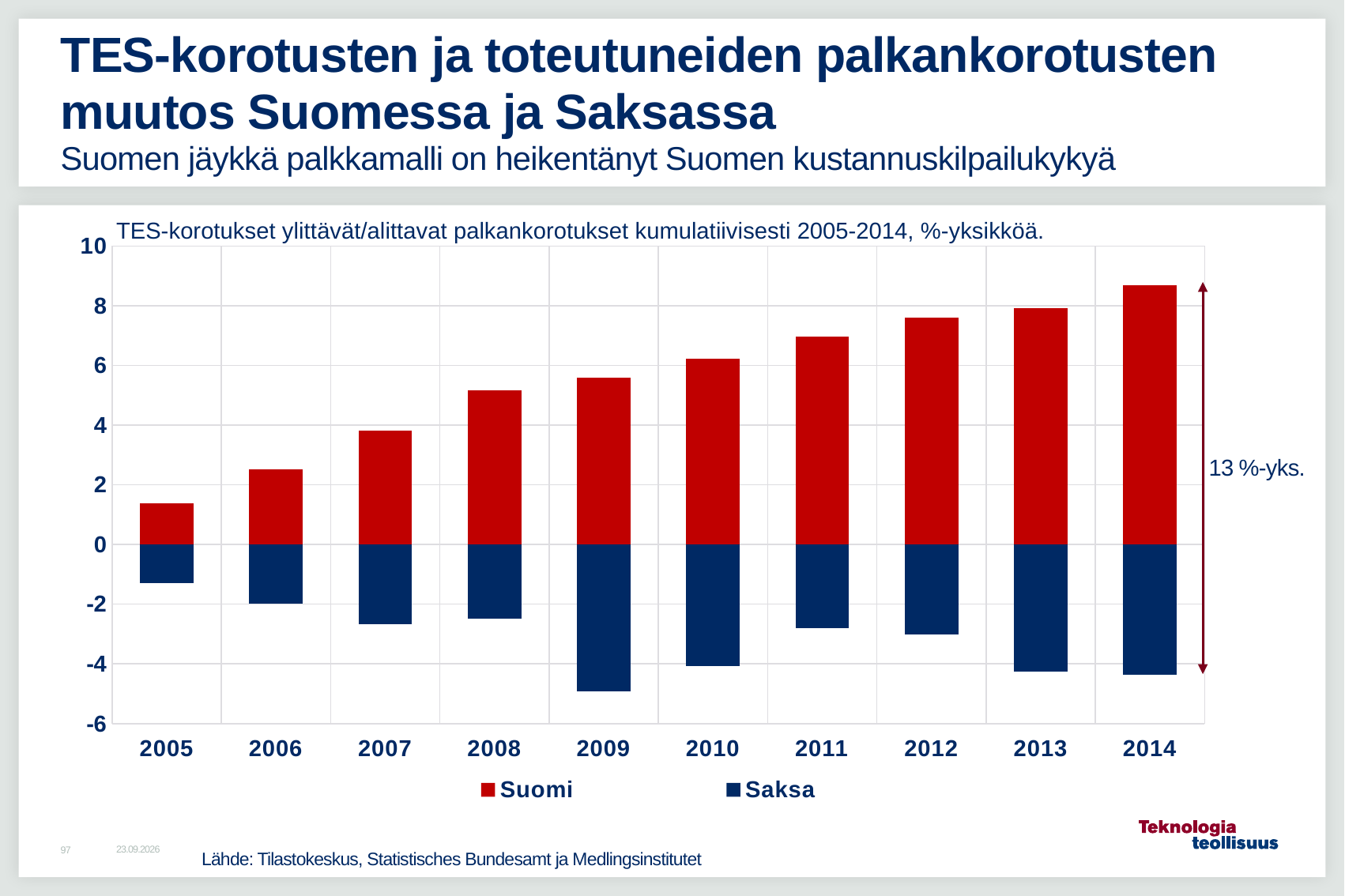
In which year does the Saksa bar reach its most negative value? 2009 How many years are shown on the x axis of the chart? 10 In which year is the Suomi bar the lowest? 2005 Which year has the larger Suomi value, 2007 or 2008? 2008 How many series does the chart legend list? 2 In which year is the Suomi bar the highest? 2014 Is the Saksa value for 2009 greater or less than -4? less What kind of chart is shown on the slide? bar chart Do the Suomi values rise or fall from 2005 to 2014? rise Is the Suomi value for 2005 greater or less than 2? less What gap between Suomi and Saksa in 2014 is annotated next to the arrow on the right of the chart? 13 %-yks. Is the Suomi value for 2014 greater or less than 8? greater